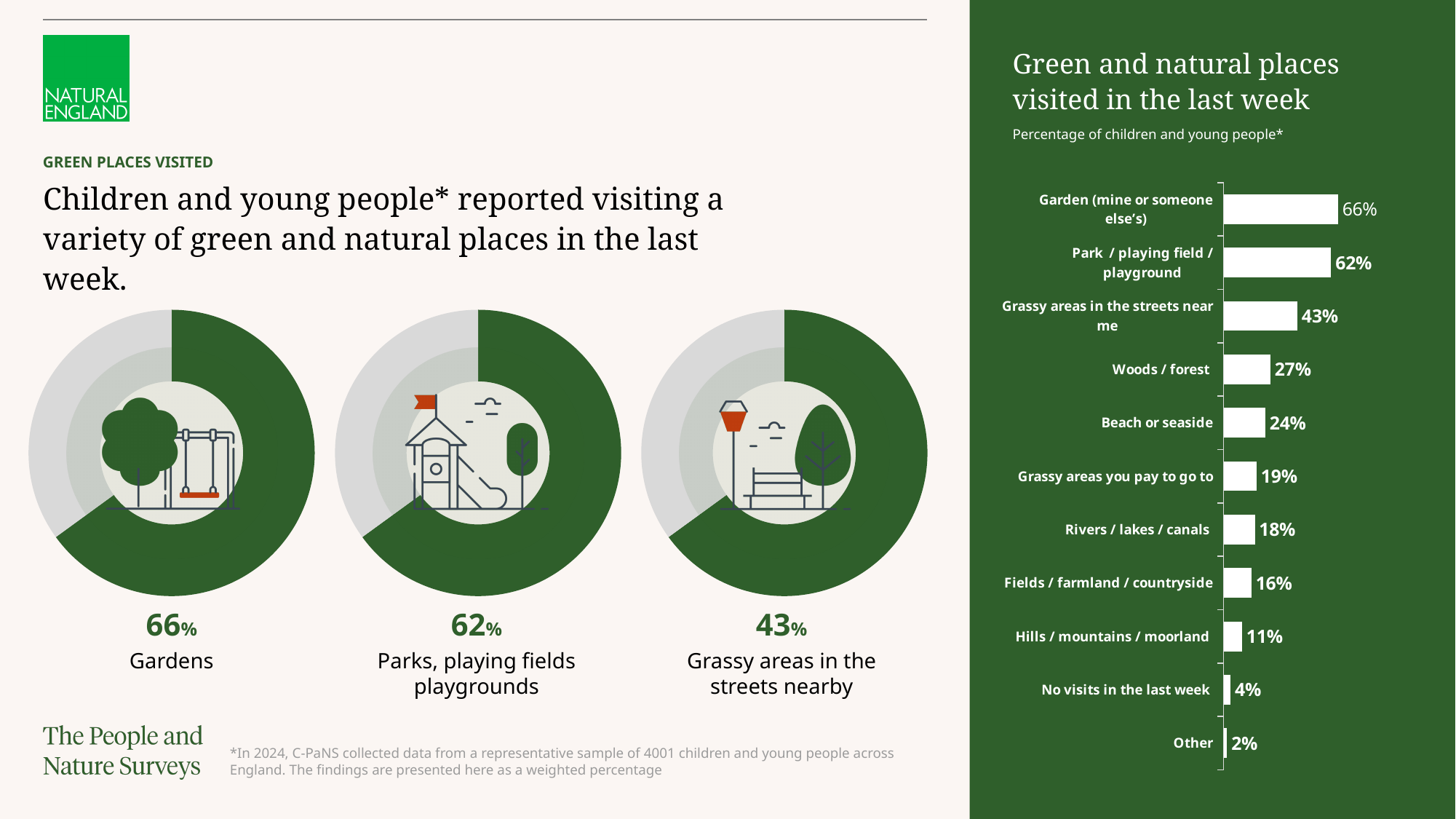
In the 'Green and natural places visited in the last week' chart, what is the difference between Grassy areas in the streets near me and Woods / forest? 16% In the 'Green and natural places visited in the last week' chart, what is the difference between the values for Garden (mine or someone else's) and Park / playing field / playground? 4% In the 'Green and natural places visited in the last week' chart, what is the value for Hills / mountains / moorland? 11% In the 'Green and natural places visited in the last week' chart, what percentage reported no visits in the last week? 4% In the 'Green and natural places visited in the last week' chart, which is larger: Rivers / lakes / canals or Fields / farmland / countryside? Rivers / lakes / canals In the 'Green and natural places visited in the last week' chart, what percentage of children and young people visited woods / forest? 27% In the 'Green and natural places visited in the last week' chart, which category has the lowest value? Other In the 'Green and natural places visited in the last week' chart, what is the value for Beach or seaside? 24% In the donut chart on the left labelled 'Grassy areas in the streets nearby', what percentage is shown? 43% What type of chart is 'Green and natural places visited in the last week'? Bar chart In the 'Green and natural places visited in the last week' chart, which category has the highest value? Garden (mine or someone else's) How many categories are shown in the 'Green and natural places visited in the last week' bar chart? 11